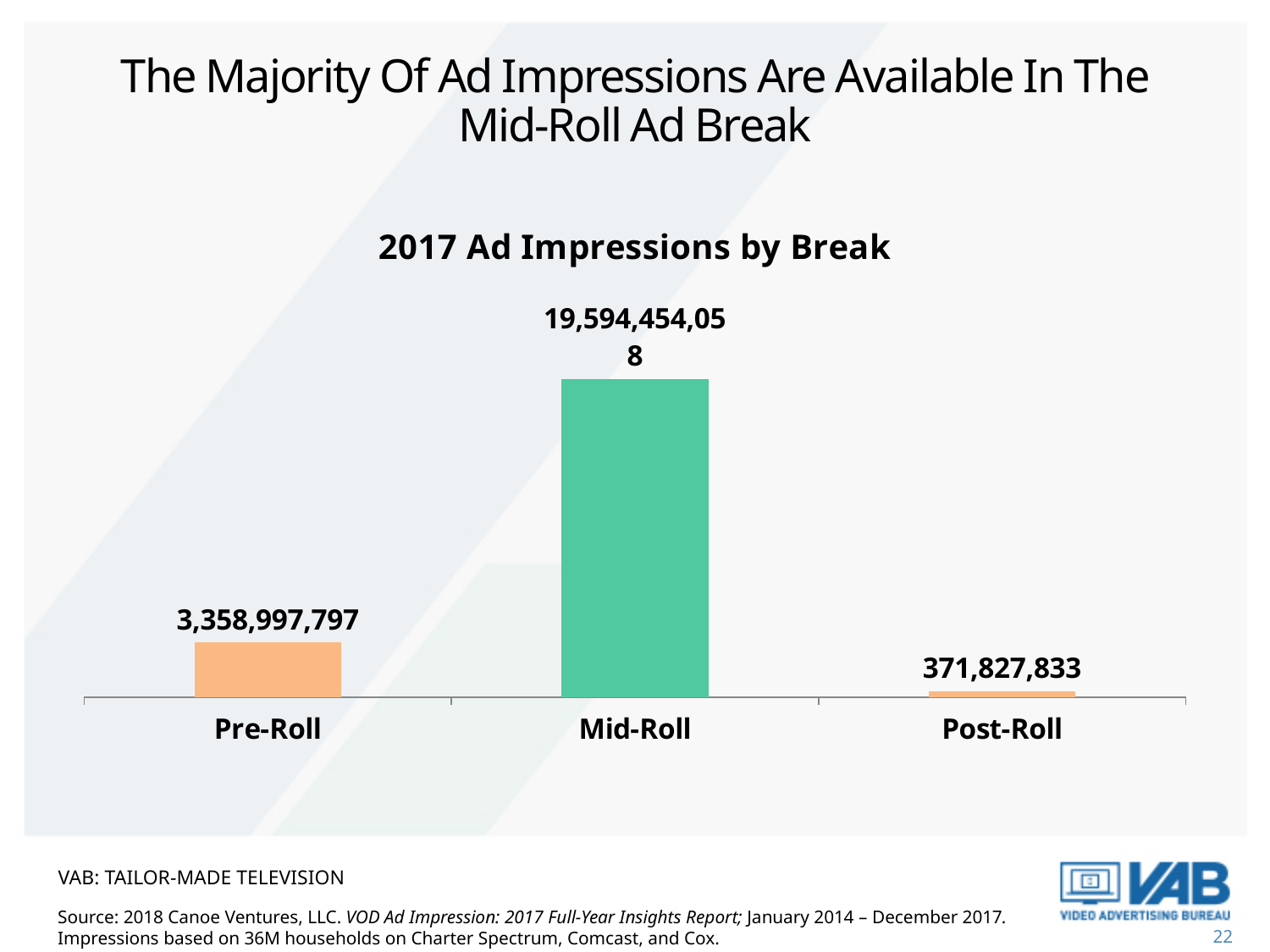
What is the difference between the Pre-Roll and Post-Roll values? 2,987,169,964 What kind of chart is shown on the slide? Bar chart Which is larger, the value for Pre-Roll or the value for Post-Roll? Pre-Roll What is the title of the chart? 2017 Ad Impressions by Break What colour is the Mid-Roll bar? Green What is the value for Post-Roll in the chart? 371,827,833 What is the difference between the Mid-Roll and Pre-Roll values? 16,235,456,261 Which ad break has the lowest number of impressions? Post-Roll How many categories are shown on the x axis of the chart? 3 What is the value for Mid-Roll in the chart? 19,594,454,058 Which ad break has the highest number of impressions? Mid-Roll What is the value for Pre-Roll in the chart? 3,358,997,797